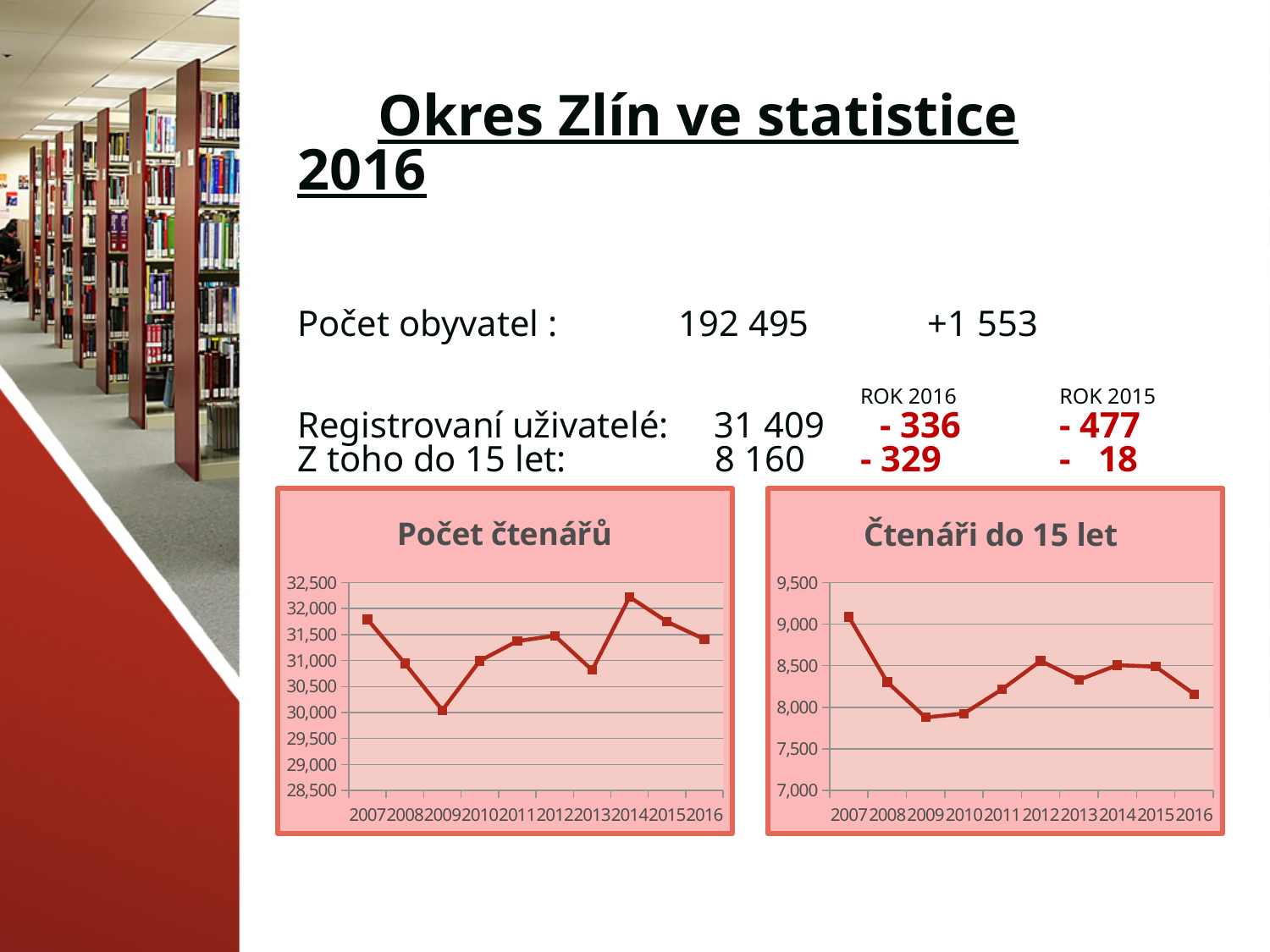
In the "Čtenáři do 15 let" chart, do the values rise or fall from 2007 to 2009? fall In the "Čtenáři do 15 let" chart, which year has the highest value? 2007 In the "Čtenáři do 15 let" chart, is the value for 2009 greater or less than 8,000? less What is the title of the chart on the right side of the slide? Čtenáři do 15 let In the "Čtenáři do 15 let" chart, which year has the larger value, 2007 or 2016? 2007 In the "Počet čtenářů" chart, is the value for 2009 greater or less than 30,500? less In the "Počet čtenářů" chart, which year has the lowest value? 2009 In the "Počet čtenářů" chart, is the value for 2014 greater or less than 32,000? greater What kind of chart is the "Počet čtenářů" chart? line chart How many years are plotted on the "Čtenáři do 15 let" chart? 10 In the "Počet čtenářů" chart, which year has the highest value? 2014